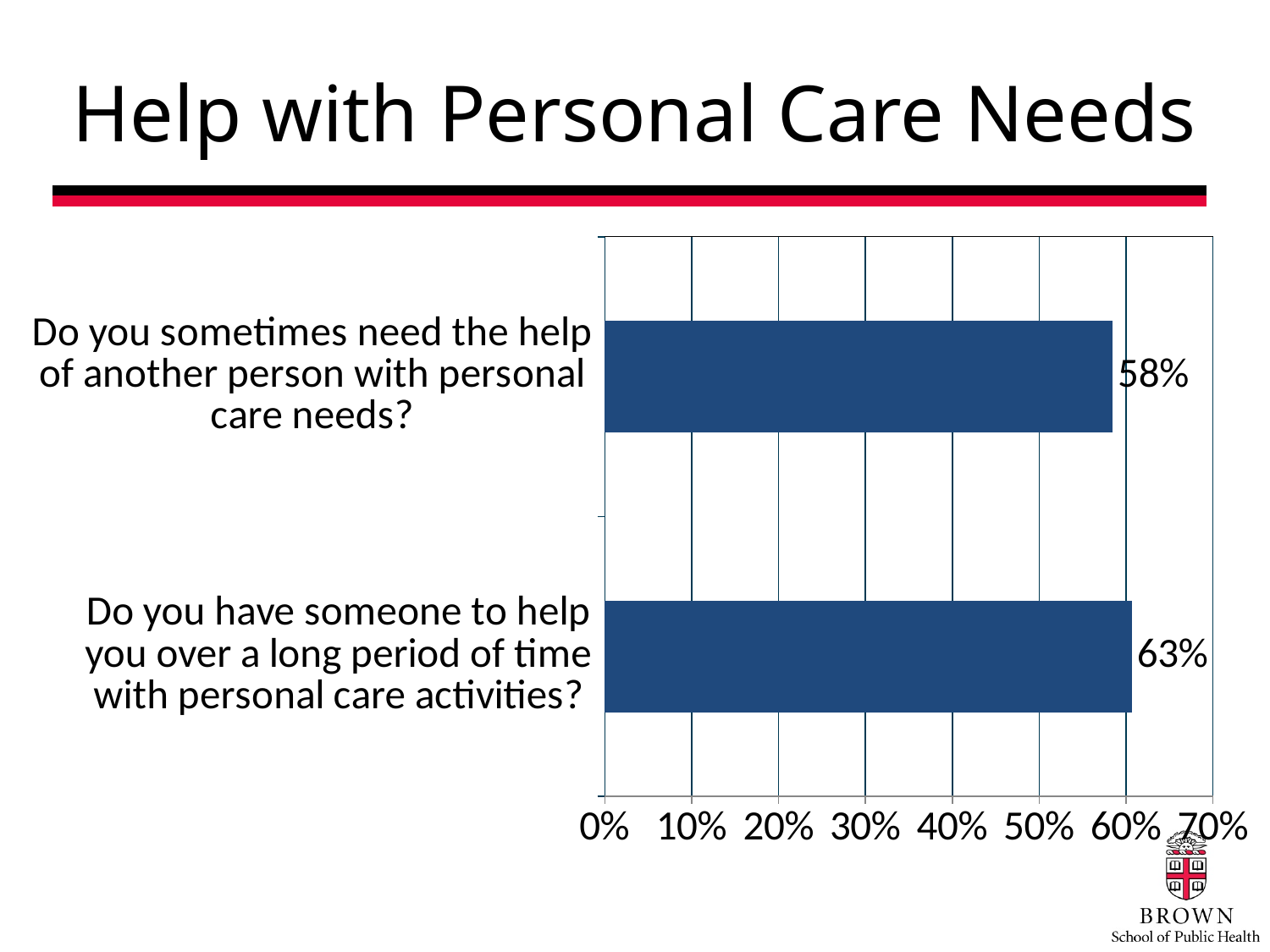
Which question has the lower value on the chart? Do you sometimes need the help of another person with personal care needs? Which question has the higher value on the chart? Do you have someone to help you over a long period of time with personal care activities? What type of chart is shown on the slide? Bar chart Is the value for "Do you sometimes need the help of another person with personal care needs?" greater or less than 60%? less How many bars are shown on the chart? 2 What is the title of the slide? Help with Personal Care Needs What is the value shown for "Do you have someone to help you over a long period of time with personal care activities?" 63% Is the value for "Do you have someone to help you over a long period of time with personal care activities?" greater or less than 60%? greater What percentage of respondents answered yes to "Do you sometimes need the help of another person with personal care needs?" 58% What is the difference in percentage points between the two bars? 5% What is the maximum value shown on the horizontal axis? 70%